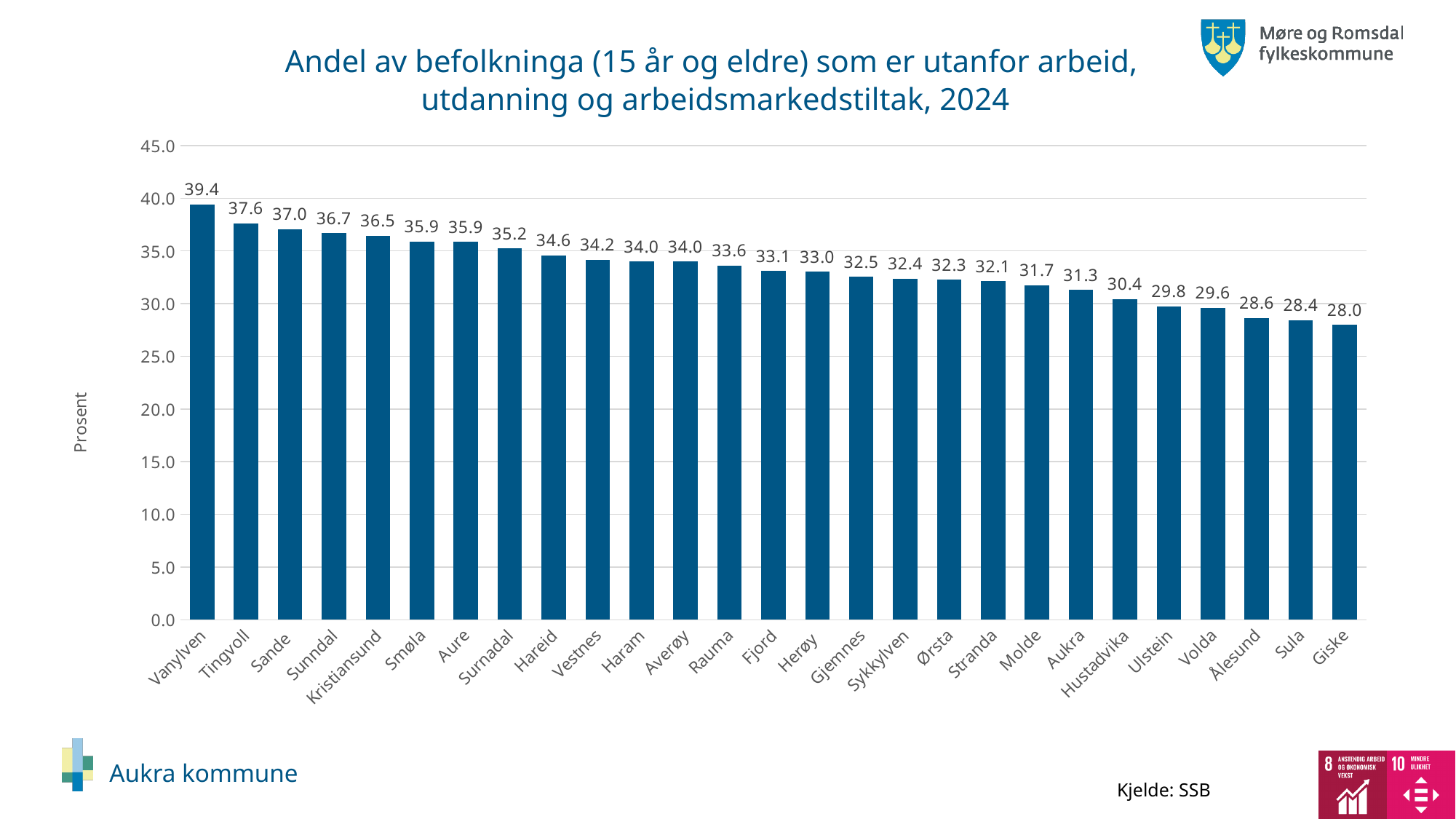
What is the difference between the values for Tingvoll and Aukra? 6.3 What is the value for Molde? 31.7 What is the value for Kristiansund? 36.5 Is the value for Hustadvika greater or less than 35.0? less Which municipality has the lowest value? Giske Which has a larger value, Sunndal or Ulstein? Sunndal Which municipality has the highest value? Vanylven What kind of chart is shown on the slide? bar chart What is the value for Aukra? 31.3 How many municipalities are shown on the chart? 27 Do the values rise or fall from left to right along the x axis? fall What is the difference between the values for Vanylven and Giske? 11.4